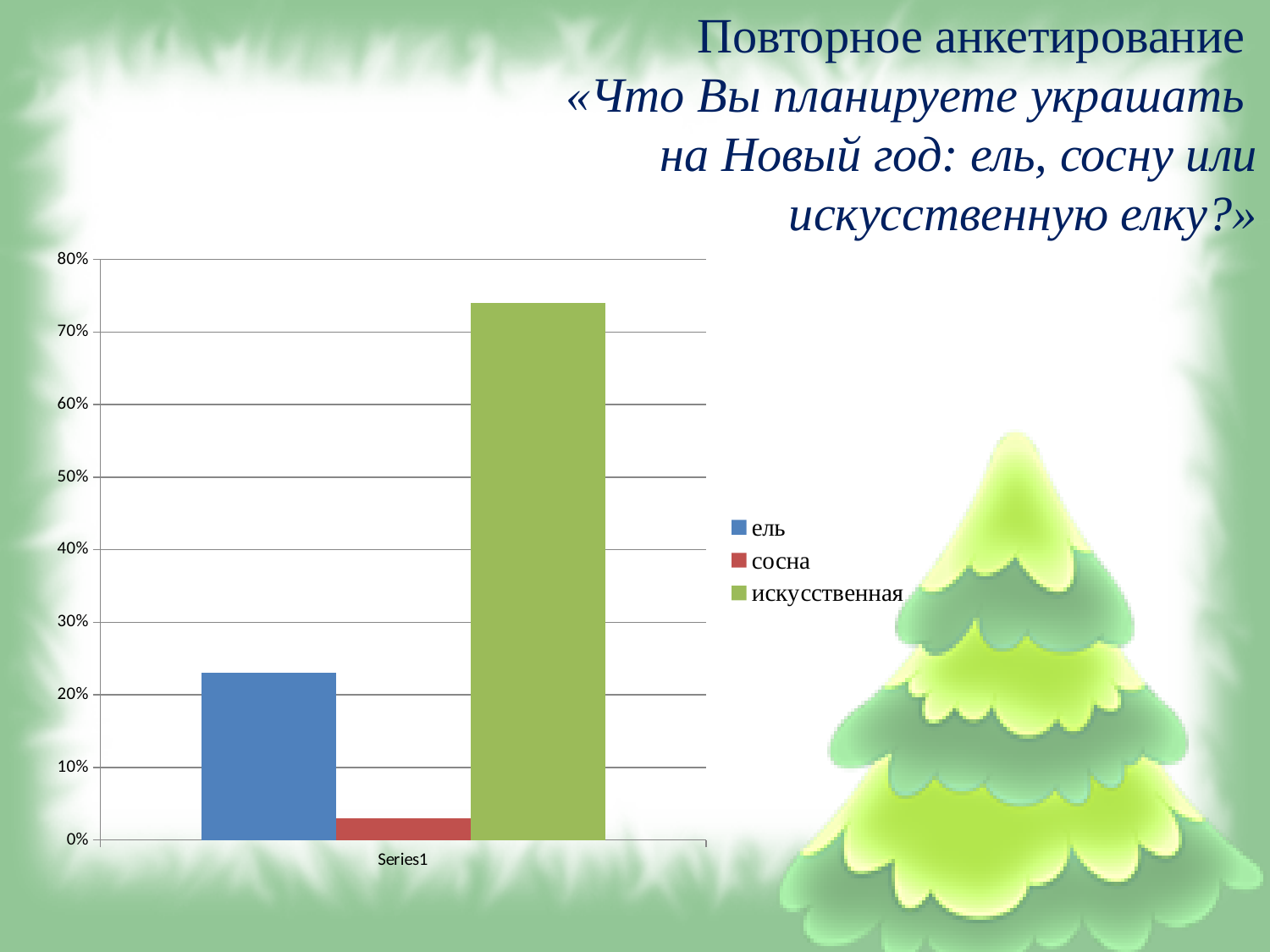
Which series has the lowest bar? сосна Which is larger, the value for ель or the value for сосна? ель How many series does the legend list? 3 Is the value for ель greater or less than 20%? greater Which is larger, the value for ель or the value for искусственная? искусственная What kind of chart is shown on the slide? bar chart Is the value for ель greater or less than 30%? less Which series has the highest bar? искусственная Is the value for искусственная greater or less than 70%? greater What colour is the bar for искусственная? green How many bars are plotted in the chart? 3